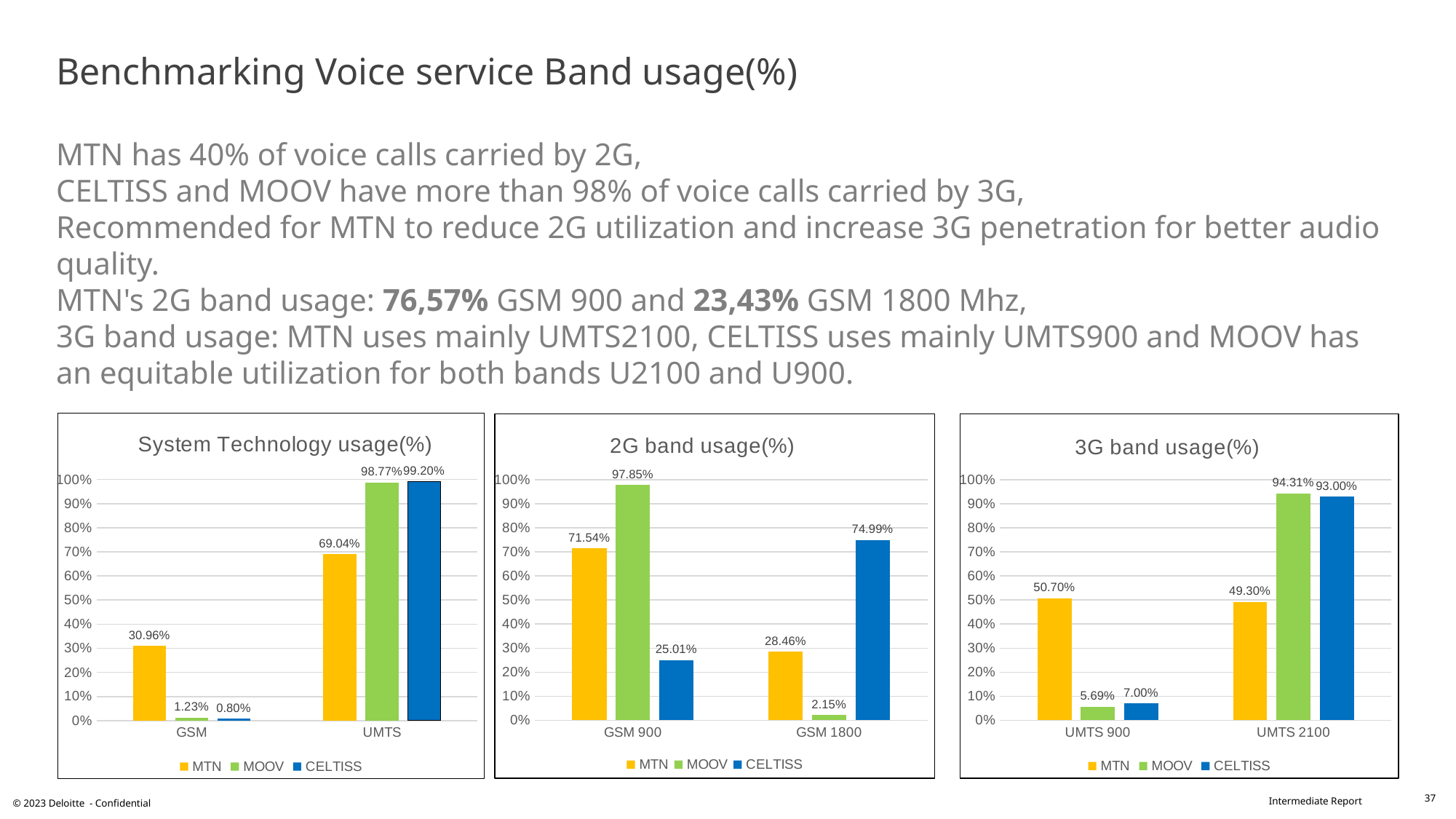
In the 'System Technology usage(%)' chart, what is the value for MTN under GSM? 30.96% In the '2G band usage(%)' chart, is MTN's value under GSM 900 larger or smaller than CELTISS's value under GSM 900? larger In the '3G band usage(%)' chart, what is the value for CELTISS under UMTS 2100? 93.00% In the 'System Technology usage(%)' chart, which operator has the highest value under UMTS? CELTISS In the '2G band usage(%)' chart, which operator has the lowest value under GSM 1800? MOOV In the '3G band usage(%)' chart, is the value for MOOV under UMTS 900 greater or less than 10%? less In the '3G band usage(%)' chart, which operator has the highest value under UMTS 900? MTN How many series does the legend of the '3G band usage(%)' chart list? 3 In the '2G band usage(%)' chart, what is the value for MOOV under GSM 900? 97.85% In the '2G band usage(%)' chart, what is the difference between CELTISS's values under GSM 1800 and GSM 900? 49.98% What type of chart is the '2G band usage(%)' chart? Bar chart In the 'System Technology usage(%)' chart, what is the difference between MOOV's and CELTISS's values under GSM? 0.43%